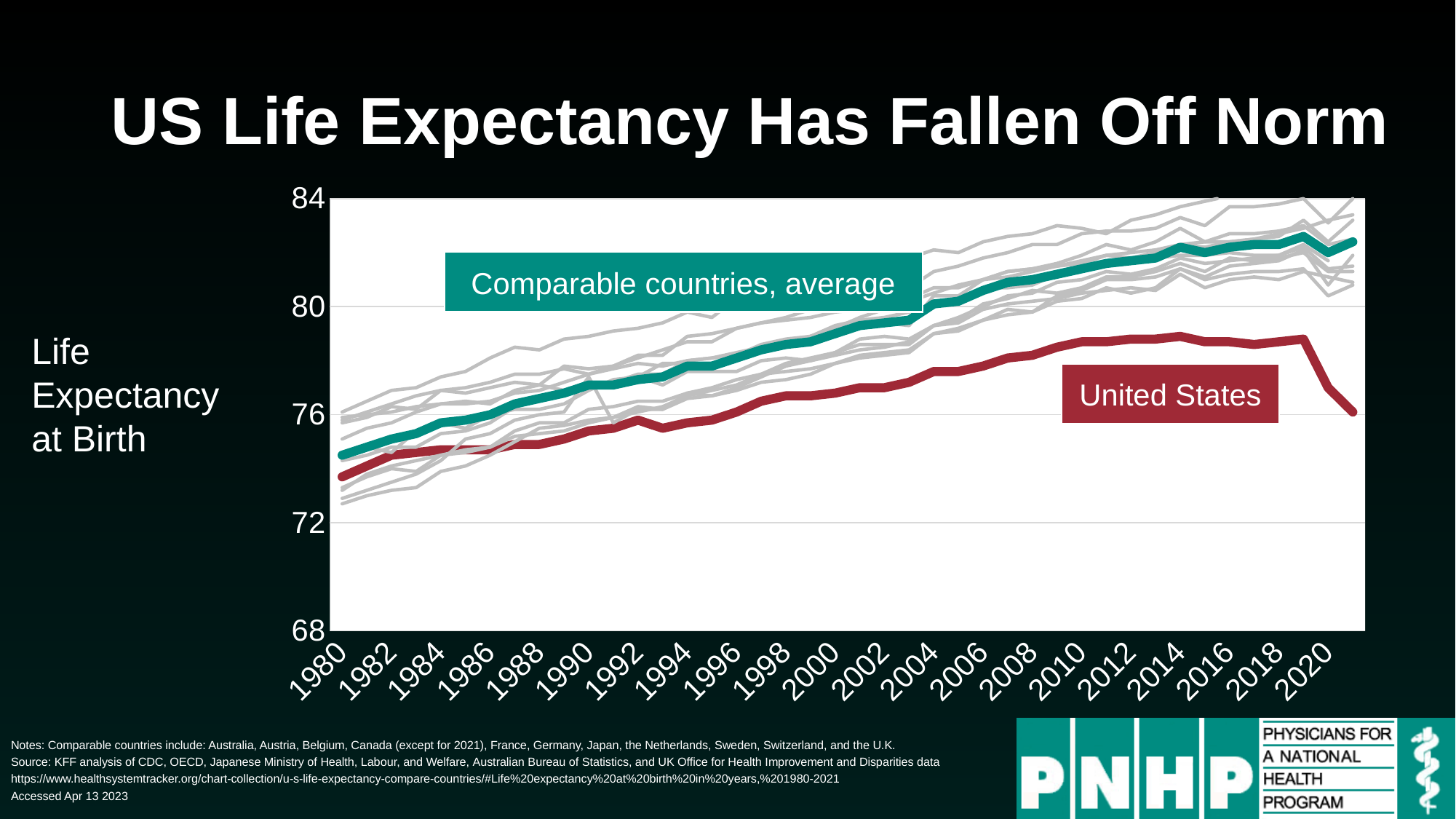
Does the United States line rise or fall between 2019 and the end of the series? fall What kind of chart is shown on the slide? line chart Is the value for United States in 1980 greater or less than 76? less Which of the two labelled series is higher in 2020, United States or Comparable countries, average? Comparable countries, average What is the title of the slide's chart? US Life Expectancy Has Fallen Off Norm Is the value for United States in 2010 greater or less than 76? greater Which of the two labelled series is higher in 1980, United States or Comparable countries, average? Comparable countries, average What does the y axis of the chart measure? Life Expectancy at Birth Does the Comparable countries, average line generally rise or fall from 1980 to 2018? rise Is the value for United States in 2014 greater or less than 80? less